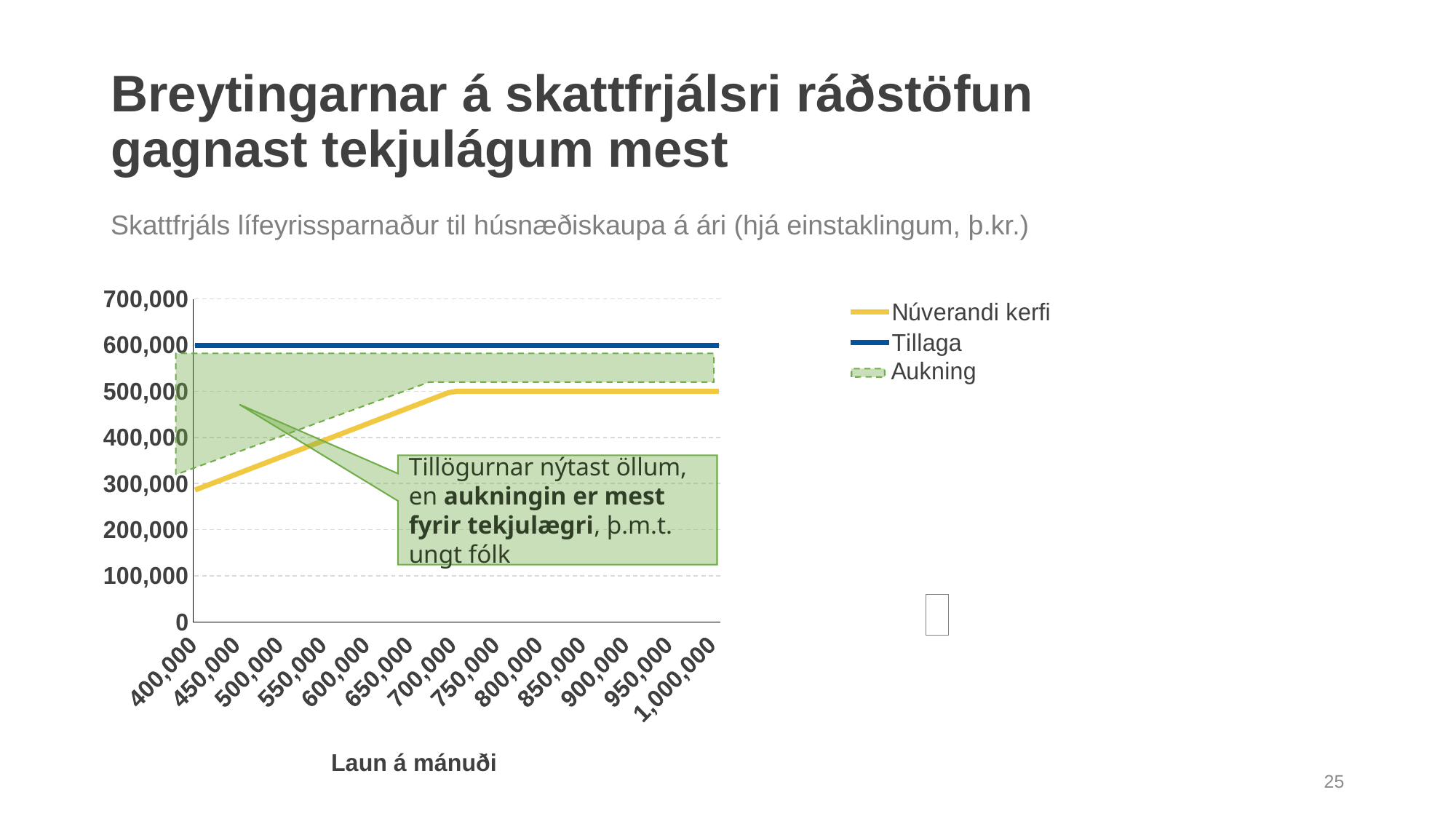
Does the Tillaga series rise, fall or stay flat as monthly salary increases? stays flat How many salary categories are shown on the x axis? 13 How many series does the legend list? 3 What is the value of the Núverandi kerfi series at a monthly salary of 900,000? 500,000 What is the value of the Tillaga series at a monthly salary of 800,000? 600,000 What is the label of the x axis? Laun á mánuði Which series is higher at a monthly salary of 500,000, Tillaga or Núverandi kerfi? Tillaga What is the difference between Tillaga and Núverandi kerfi at a monthly salary of 1,000,000? 100,000 Does the Núverandi kerfi series rise or fall between monthly salaries of 400,000 and 700,000? rise What kind of chart is shown on the slide? line chart Is the value for Núverandi kerfi at a monthly salary of 400,000 greater or less than 300,000? less